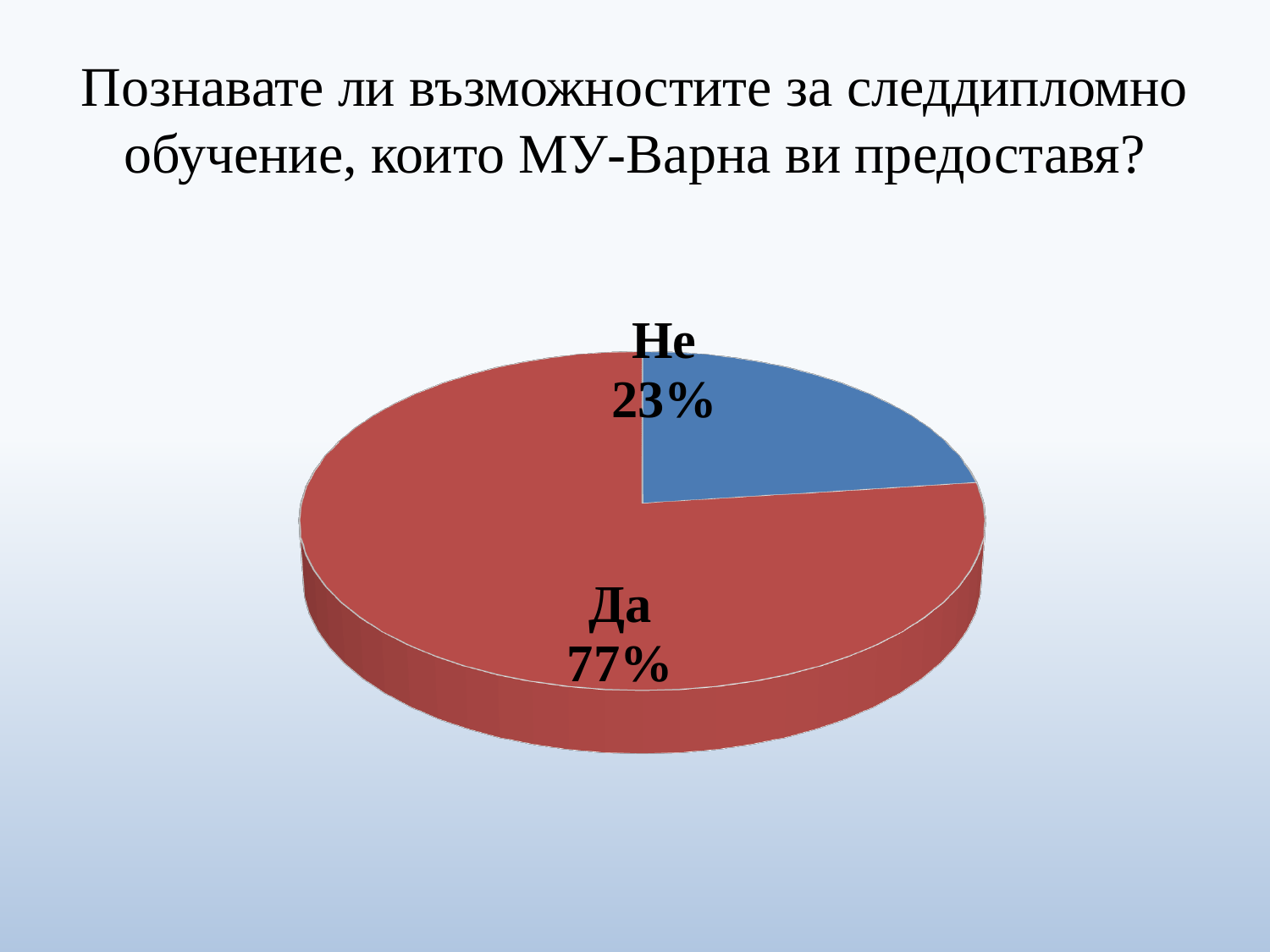
What kind of chart is shown on the slide? pie chart What colour is the "Да" slice? red What share of the pie does the "Не" slice represent? 23% What percentage of respondents answered "Не"? 23% What percentage of respondents answered "Да"? 77% How many slices does the pie chart have? 2 What colour is the "Не" slice? blue What is the difference in percentage points between the "Да" and "Не" slices? 54 Which is larger, the "Да" slice or the "Не" slice? Да Which slice of the pie is the largest? Да Which slice of the pie is the smallest? Не